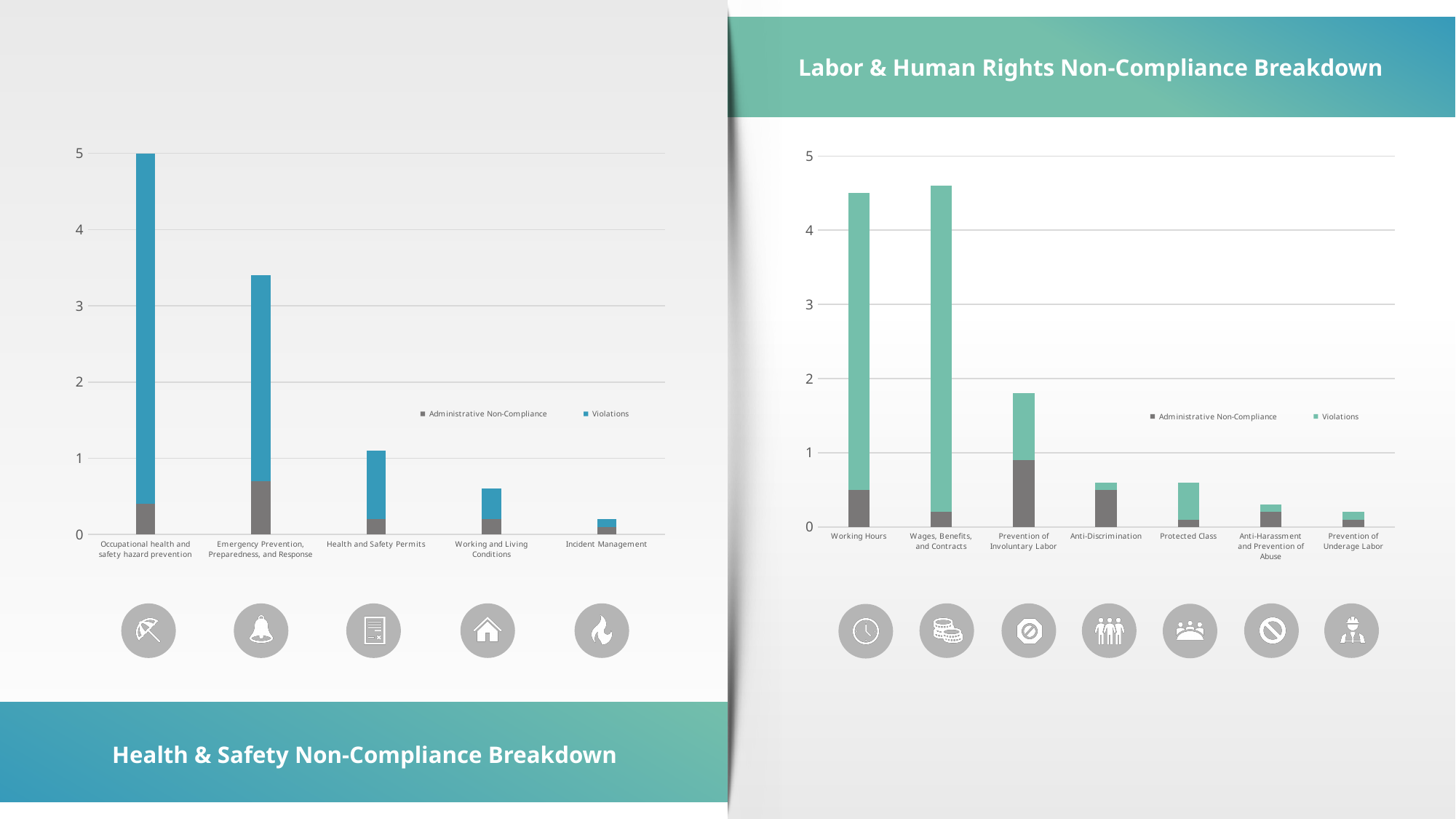
How many categories are shown on the Labor & Human Rights Non-Compliance Breakdown chart? 7 On the Health & Safety Non-Compliance Breakdown chart, is the total value for Working and Living Conditions greater or less than 1? less What kind of chart is the Health & Safety Non-Compliance Breakdown chart? Stacked bar chart On the Health & Safety Non-Compliance Breakdown chart, is the total value for Emergency Prevention, Preparedness, and Response greater or less than 3? greater What are the two series named in the legend of the Health & Safety Non-Compliance Breakdown chart? Administrative Non-Compliance and Violations On the Labor & Human Rights Non-Compliance Breakdown chart, is the total value for Working Hours greater or less than 4? greater On the Health & Safety Non-Compliance Breakdown chart, which category has the highest total bar? Occupational health and safety hazard prevention How many categories are shown on the Health & Safety Non-Compliance Breakdown chart? 5 How many series does the legend of the Labor & Human Rights Non-Compliance Breakdown chart list? 2 On the Health & Safety Non-Compliance Breakdown chart, which category has the lowest total bar? Incident Management On the Labor & Human Rights Non-Compliance Breakdown chart, which has the larger total bar: Working Hours or Prevention of Involuntary Labor? Working Hours